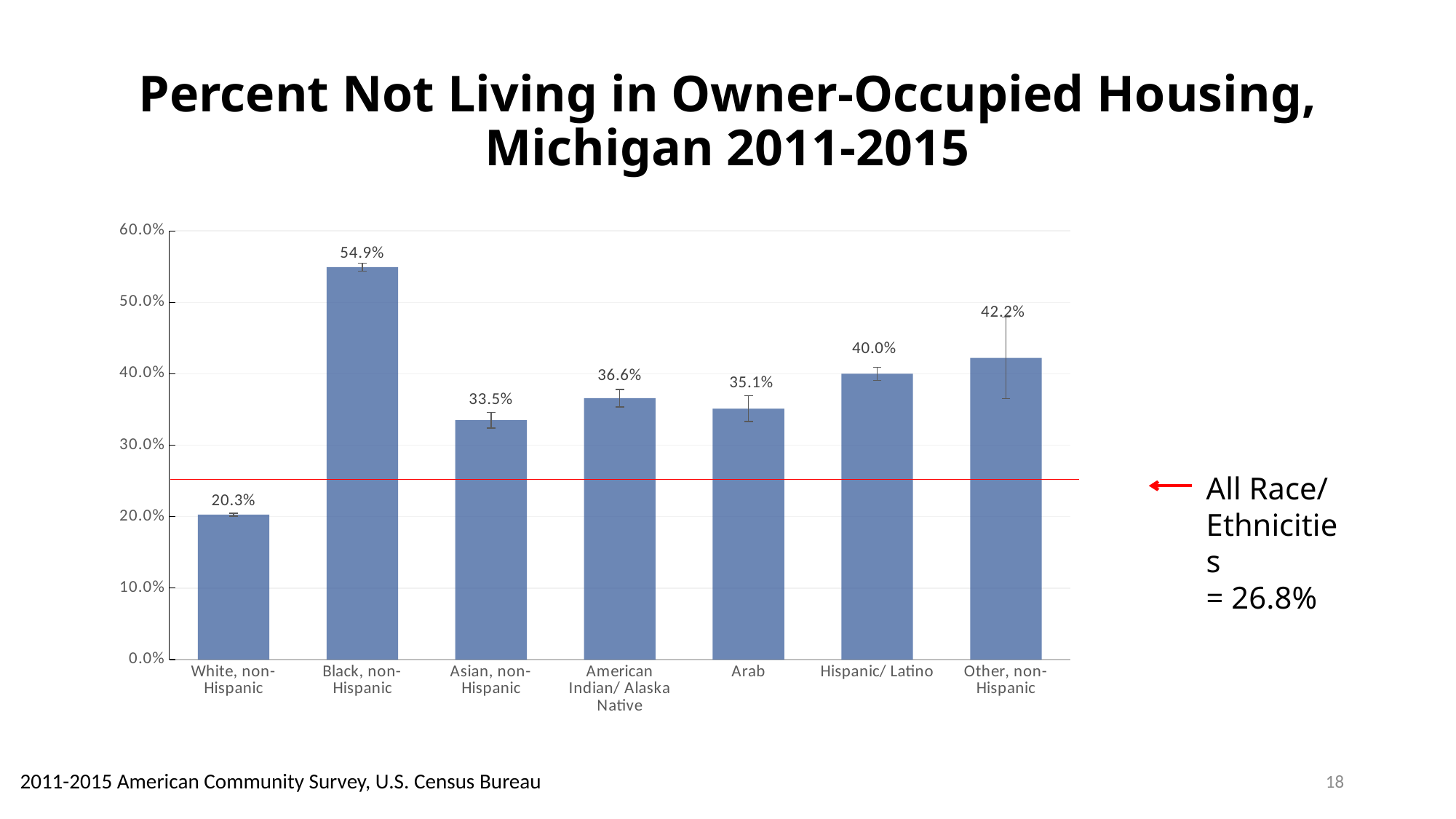
Which category has the highest percent not living in owner-occupied housing? Black, non-Hispanic How many race/ethnicity categories are shown on the chart? 7 What is the title of the chart? Percent Not Living in Owner-Occupied Housing, Michigan 2011-2015 What is the value shown for Hispanic/ Latino? 40.0% Which category has the lowest percent not living in owner-occupied housing? White, non-Hispanic What value does the red horizontal line represent for all race/ethnicities? 26.8% Is the value for American Indian/ Alaska Native greater or less than 30.0%? greater What kind of chart is shown on the slide? Bar chart What is the value shown for Arab? 35.1% Which is larger, the value for Other, non-Hispanic or the value for Hispanic/ Latino? Other, non-Hispanic What is the percent not living in owner-occupied housing for Black, non-Hispanic? 54.9% What is the difference between the values for Black, non-Hispanic and White, non-Hispanic? 34.6%